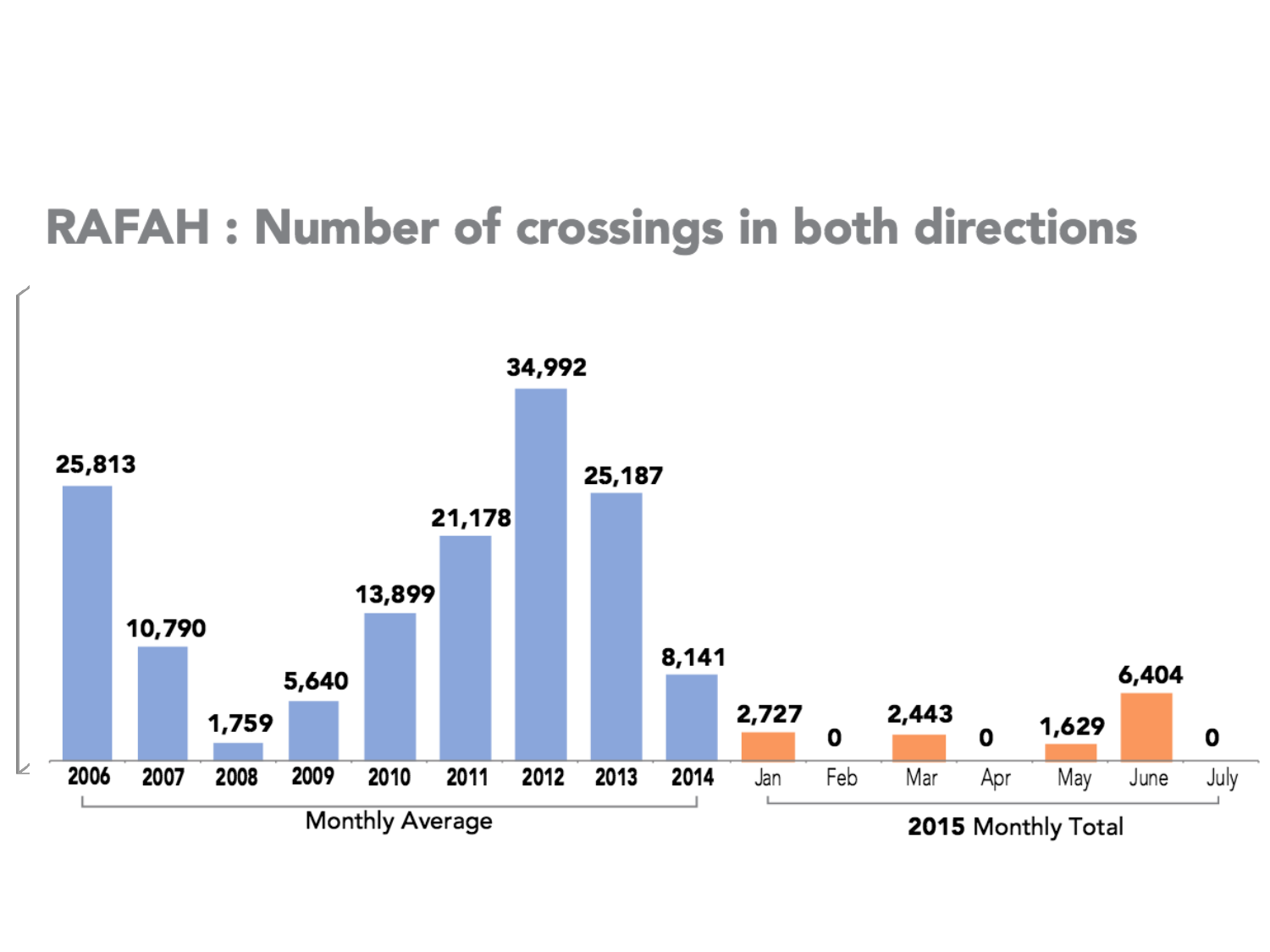
What is the 2015 monthly total for Jan? 2,727 What is the monthly average number of crossings for 2012? 34,992 Which year has the highest monthly average number of crossings? 2012 What is the 2015 monthly total for June? 6,404 How many months of 2015 are shown on the chart? 7 What is the monthly average number of crossings for 2008? 1,759 What is the title of the chart? RAFAH : Number of crossings in both directions Which is larger, the monthly average for 2006 or for 2013? 2006 Which year has the lowest monthly average number of crossings? 2008 What is the difference between the 2015 monthly totals for June and Jan? 3,677 What kind of chart is shown on the slide? Bar chart What is the difference between the monthly average for 2012 and for 2013? 9,805